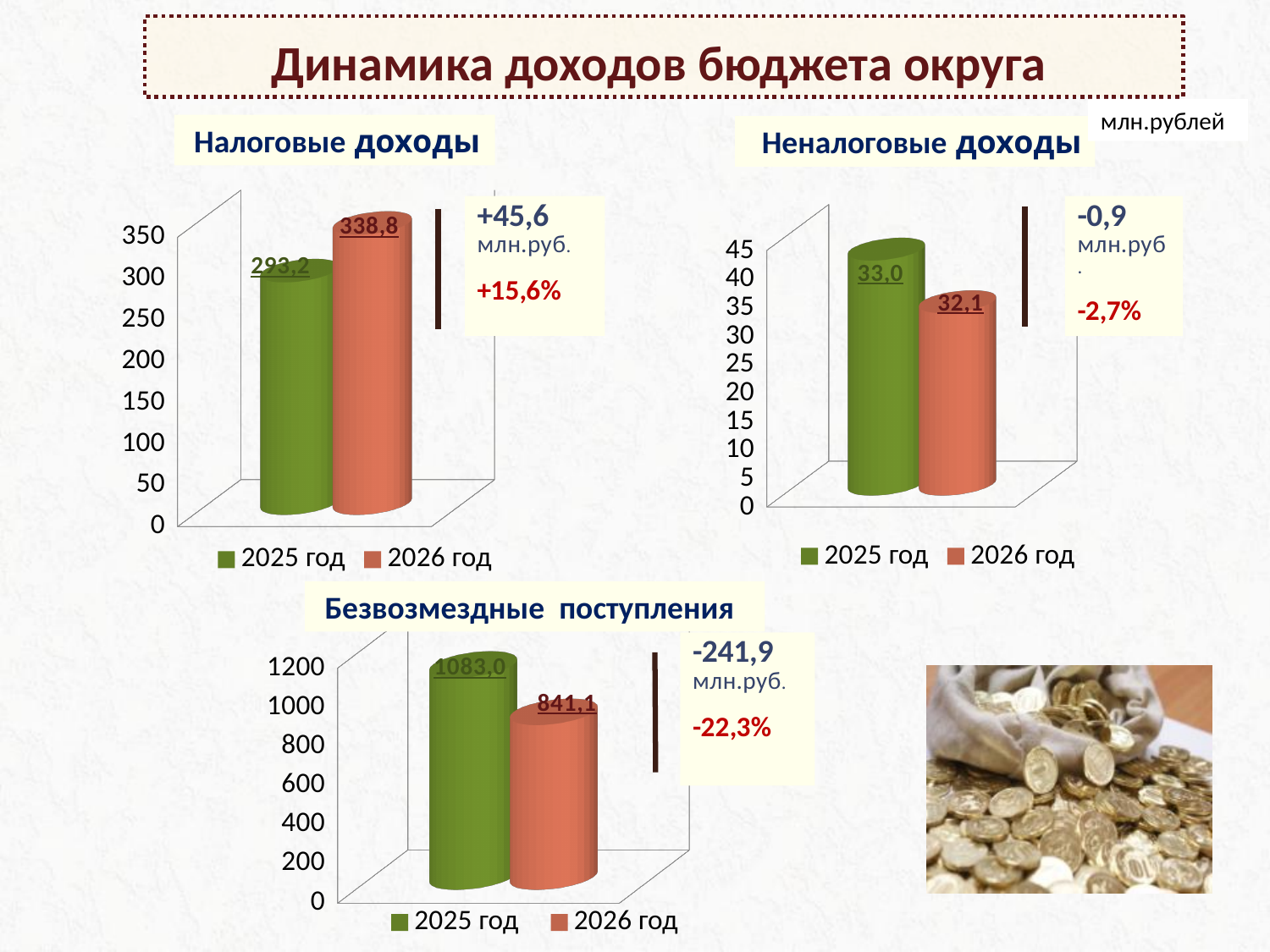
In the 'Неналоговые доходы' chart, what is the value for 2026 год? 32,1 In the 'Налоговые доходы' chart, which year has the higher value? 2026 год In the 'Налоговые доходы' chart, what is the difference between the 2026 год and 2025 год values? 45,6 How many series does the legend of the 'Неналоговые доходы' chart list? 2 What kind of chart is the 'Безвозмездные поступления' chart? Bar chart In the 'Безвозмездные поступления' chart, what is the difference between the 2025 год and 2026 год values? 241,9 In the 'Неналоговые доходы' chart, what is the value for 2025 год? 33,0 In the 'Налоговые доходы' chart, what is the value for 2026 год? 338,8 In the 'Безвозмездные поступления' chart, which year has the lowest value? 2026 год In the 'Безвозмездные поступления' chart, what is the value for 2025 год? 1083,0 In the 'Безвозмездные поступления' chart, what is the value for 2026 год? 841,1 In the 'Налоговые доходы' chart, what is the value for 2025 год? 293,2